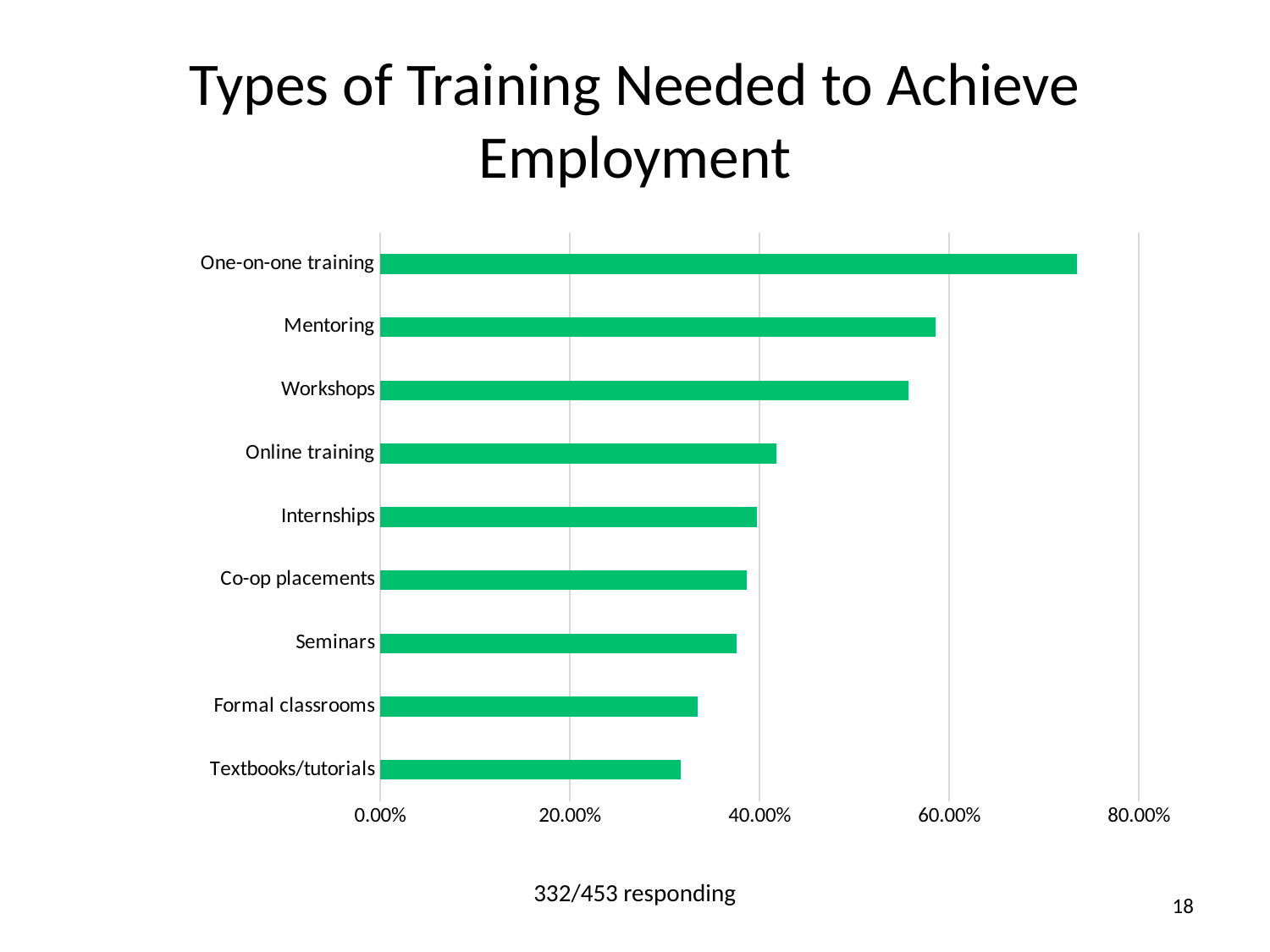
What is the title of the chart on the slide? Types of Training Needed to Achieve Employment Which type of training has the lowest value? Textbooks/tutorials Is the value for One-on-one training greater or less than 60.00%? greater Which is larger, the value for Seminars or the value for Mentoring? Mentoring Which type of training has the highest value? One-on-one training What kind of chart is shown on the slide? bar chart Is the value for Textbooks/tutorials greater or less than 20.00%? greater Which is larger, the value for Workshops or the value for Internships? Workshops Is the value for Online training greater or less than 40.00%? greater How many types of training are listed on the chart? 9